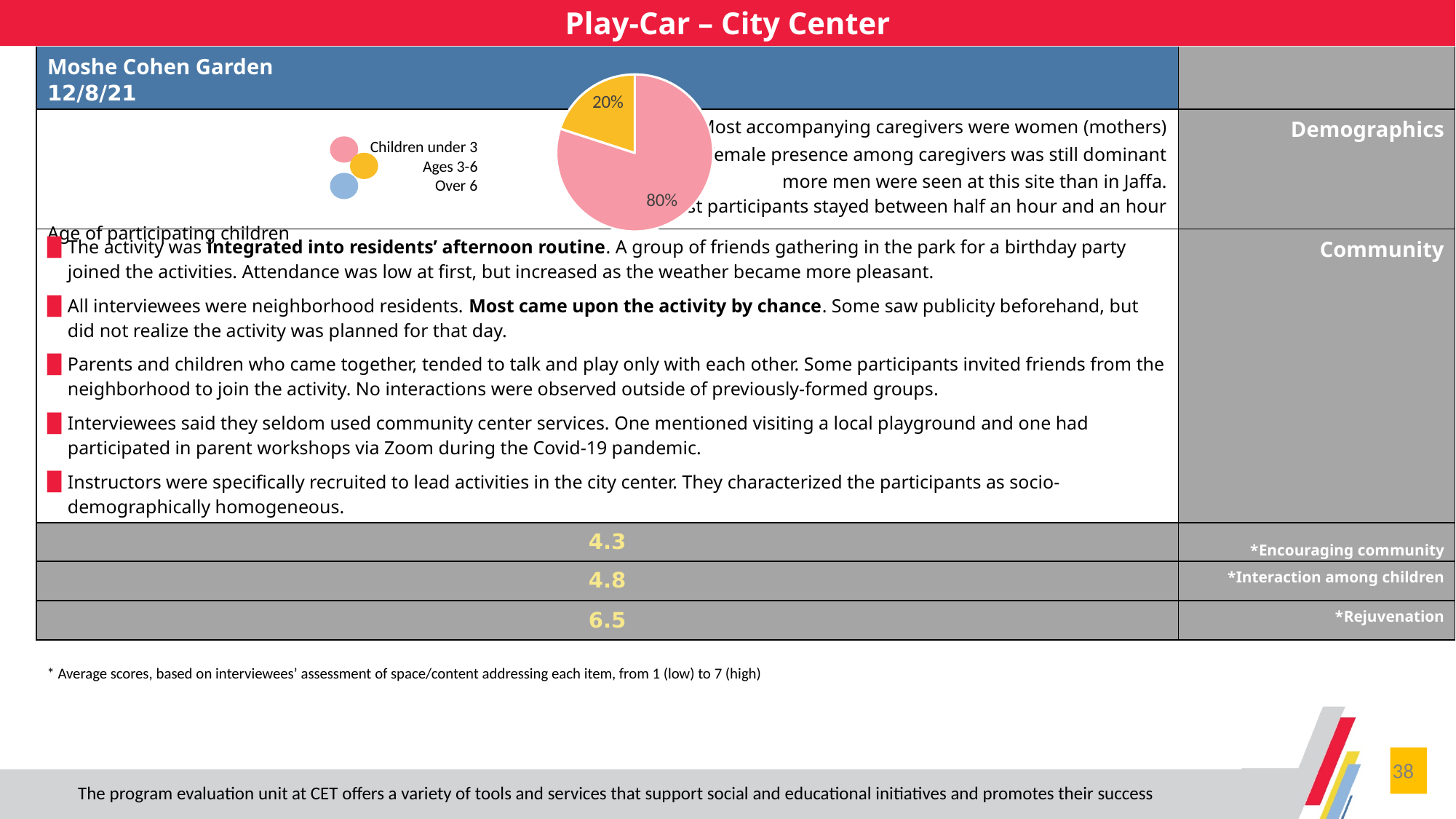
What share of the pie is labeled for Ages 3-6? 20% Which is larger, the slice for Children under 3 or the slice for Ages 3-6? Children under 3 What colour is the slice for Ages 3-6? yellow What is the title of the chart on the slide? Age of participating children What is the difference in percentage points between the Children under 3 slice and the Ages 3-6 slice? 60% Is the share for Children under 3 greater or less than 50%? greater What do the two labeled slices of the pie add up to? 100% Which age group has the largest slice of the pie? Children under 3 What share of the pie is labeled for Children under 3? 80% What kind of chart is shown on the slide? pie chart How many entries does the chart's legend list? 3 How many slices of the pie have a percentage label? 2